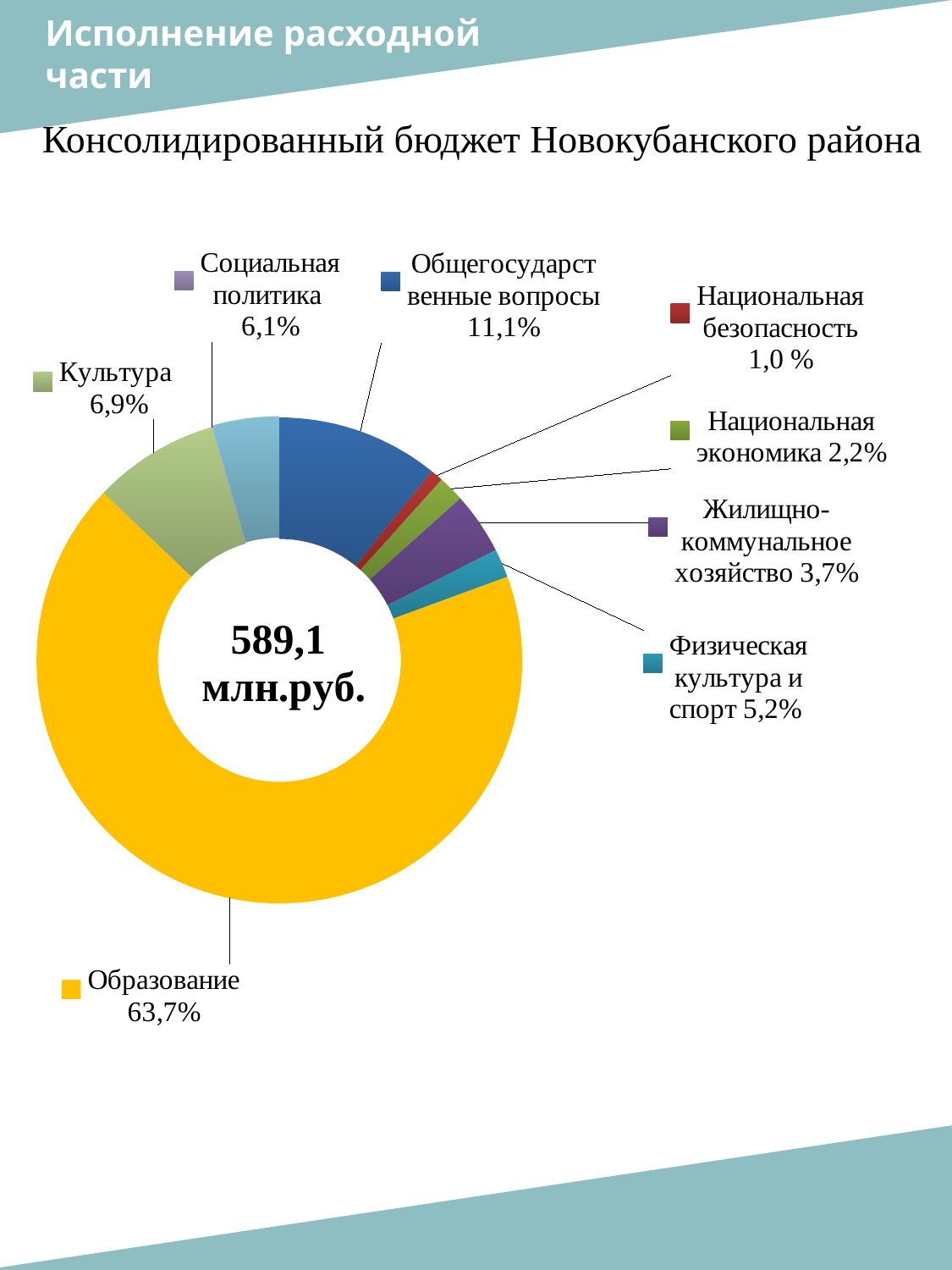
How many categories are shown in the chart? 8 What is the difference in percentage points between Образование and Общегосударственные вопросы? 52,6 Which category has the smallest share of the budget? Национальная безопасность What share of the budget goes to Общегосударственные вопросы? 11,1% Which is larger: the share for Национальная экономика or for Жилищно-коммунальное хозяйство? Жилищно-коммунальное хозяйство What share of the budget goes to Физическая культура и спорт? 5,2% What type of chart is shown on the slide? Doughnut (pie) chart Which category has the largest share of the budget? Образование What share of the budget goes to Образование? 63,7% What is the difference in percentage points between Культура and Социальная политика? 0,8 What total amount is shown in the centre of the chart? 589,1 млн.руб. What share of the budget goes to Жилищно-коммунальное хозяйство? 3,7%